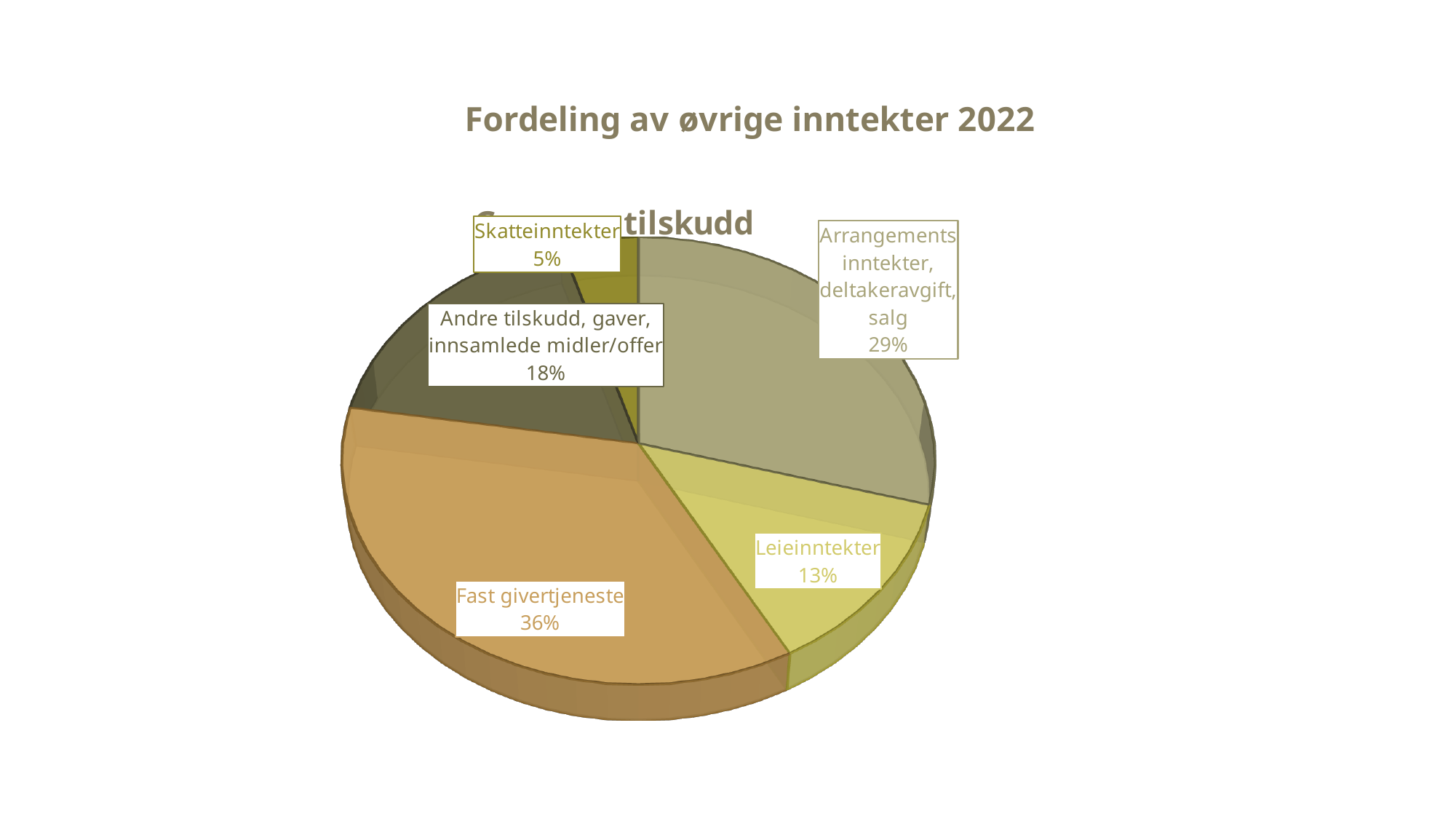
What share of the pie is Arrangementsinntekter, deltakeravgift, salg? 29% What percentage does the Fast givertjeneste slice represent? 36% What is the difference in percentage points between Fast givertjeneste and Leieinntekter? 23 percentage points Which category has the smallest slice of the pie? Skatteinntekter How many slices does the pie chart have? 5 What percentage is shown for Andre tilskudd, gaver, innsamlede midler/offer? 18% Which category has the largest slice of the pie? Fast givertjeneste What percentage is shown for Leieinntekter? 13% What percentage is shown for Skatteinntekter? 5% What is the title of the chart? Fordeling av øvrige inntekter 2022 What kind of chart is shown on the slide? Pie chart Which is larger, the Arrangementsinntekter, deltakeravgift, salg slice or the Andre tilskudd, gaver, innsamlede midler/offer slice? Arrangementsinntekter, deltakeravgift, salg